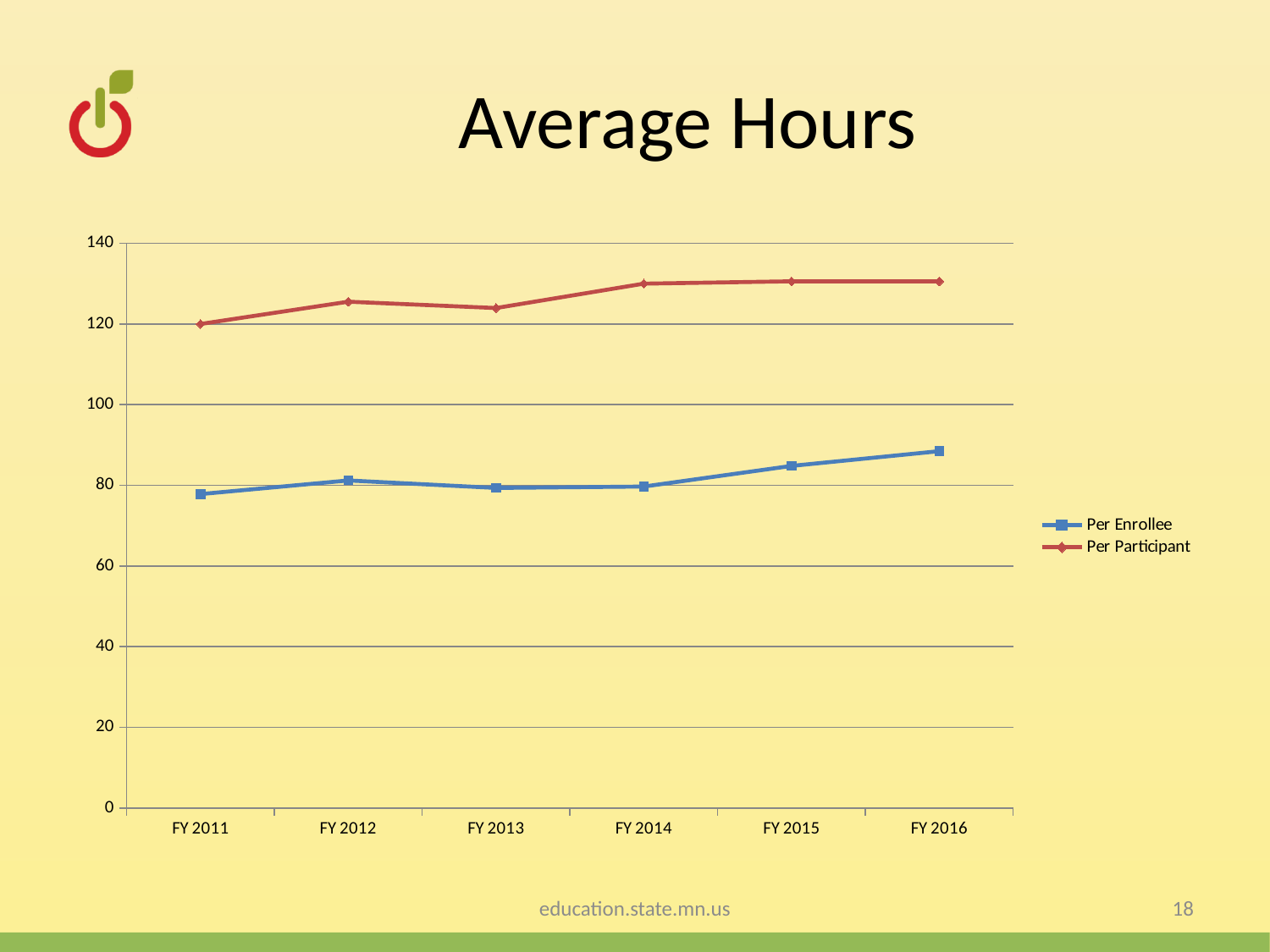
How many series does the legend list? 2 In which fiscal year is the Per Enrollee value highest? FY 2016 What is the title of the chart? Average Hours In which fiscal year is the Per Participant value lowest? FY 2011 Is the Per Participant value for FY 2014 greater or less than 120? greater Is the Per Participant value for FY 2016 greater or less than 140? less Is the Per Enrollee value for FY 2016 greater or less than 80? greater What kind of chart is shown on the slide? line chart Which two series are listed in the legend? Per Enrollee and Per Participant In FY 2013, which series has the larger value, Per Enrollee or Per Participant? Per Participant How many fiscal years are plotted along the x axis? 6